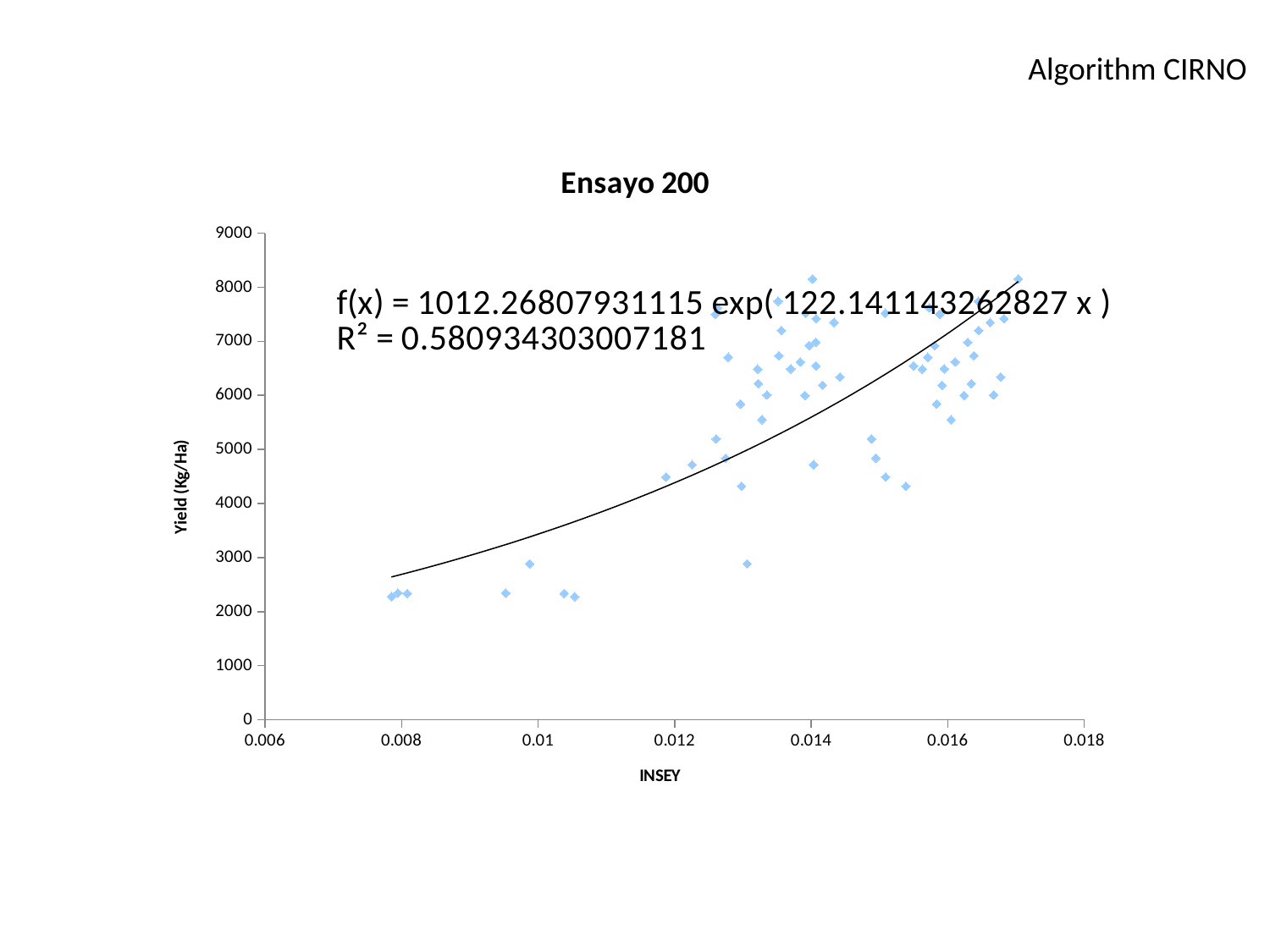
Is the yield of the point at INSEY 0.0099 greater or less than 2000? greater Does yield generally rise or fall as INSEY increases along the x axis? Rise What is the label of the y axis? Yield (Kg/Ha) What is the maximum value shown on the y axis? 9000 Is the highest plotted yield value greater or less than 8000? greater What is the title of the chart? Ensayo 200 Is the lowest plotted yield value greater or less than 3000? less What is the minimum value shown on the x axis? 0.006 What is the fitted equation shown on the chart? f(x) = 1012.26807931115 exp( 122.141143262827 x ) What kind of chart is shown on the slide? Scatter chart What is the R² value shown on the chart? 0.580934303007181